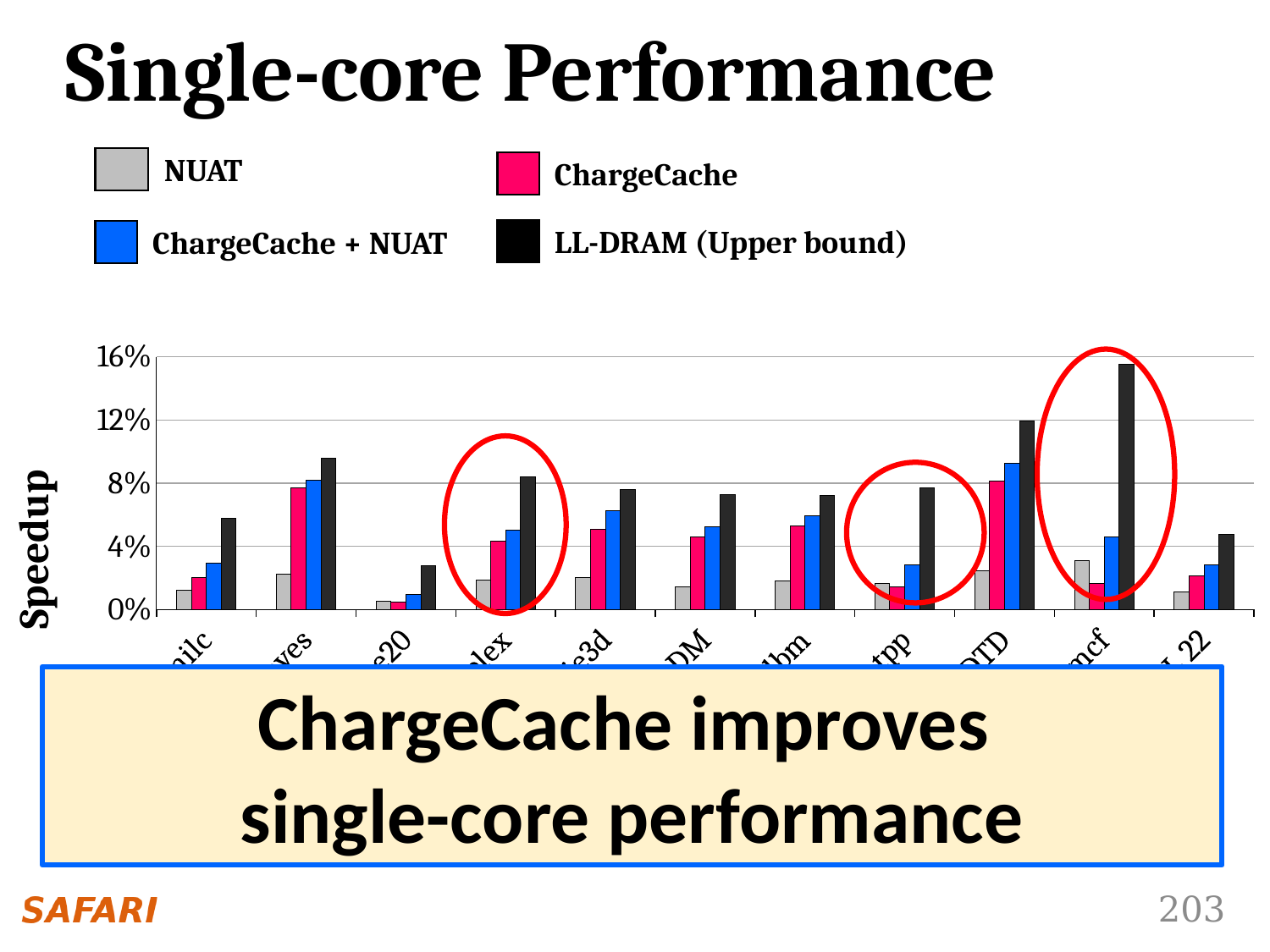
In the ninth category group from the left, is the LL-DRAM (Upper bound) value greater or less than 8%? greater In the second category group from the left, is the ChargeCache value greater or less than 4%? greater Which series has the tallest bar anywhere in the chart? LL-DRAM (Upper bound) What kind of chart is shown on the slide? bar chart What is the label of the y axis? Speedup How many category groups are plotted along the x axis? 11 In the first category group from the left, which is larger: the NUAT bar or the ChargeCache + NUAT bar? ChargeCache + NUAT Which series has the lowest bar in the tenth category group from the left? ChargeCache Which series is shown in black in the legend? LL-DRAM (Upper bound) How many series does the legend list? 4 Is the highest NUAT value in the chart greater or less than 4%? less